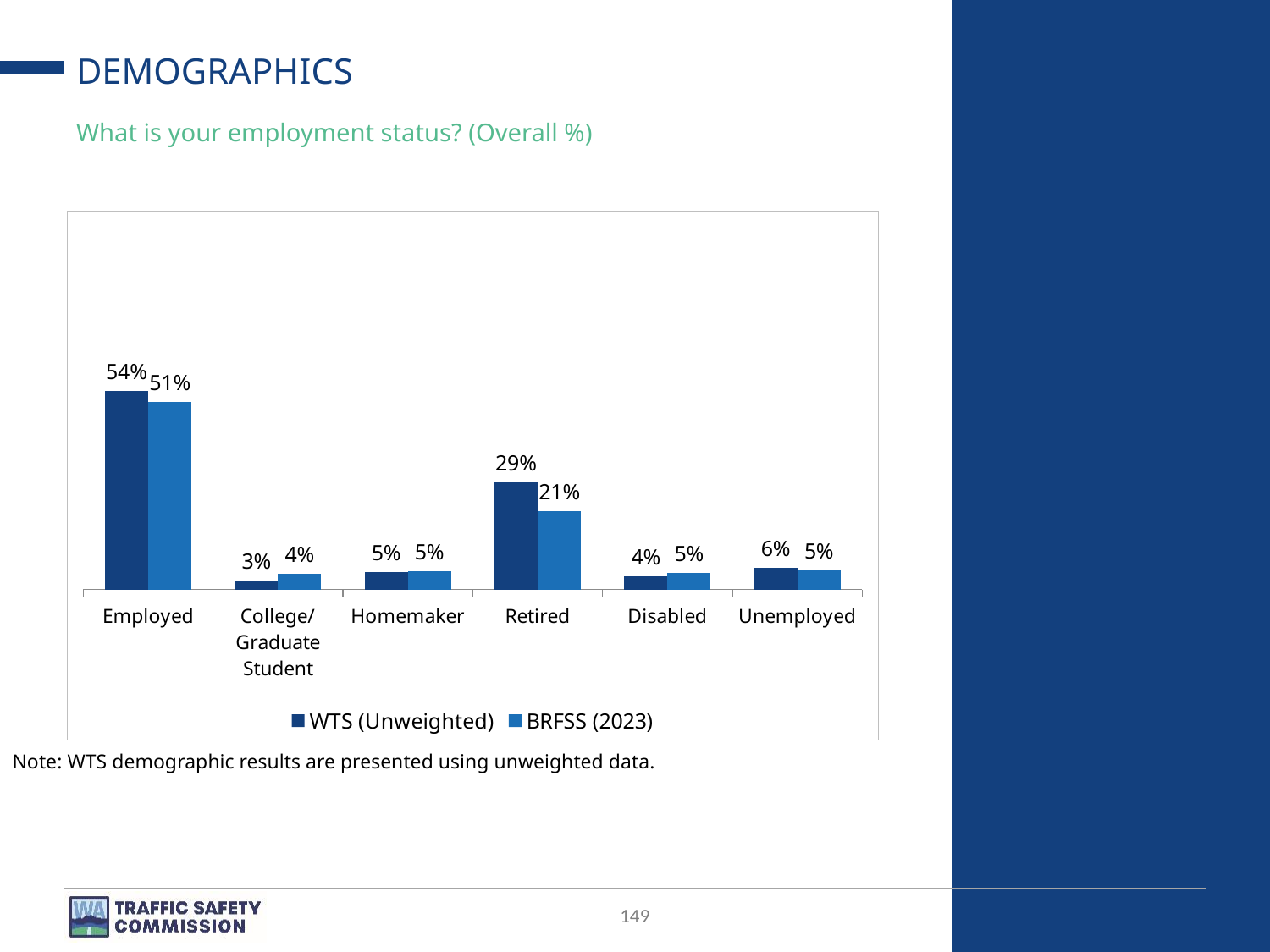
How many employment status categories are shown on the chart? 6 What is the difference between the WTS (Unweighted) and BRFSS (2023) values for Retired? 8% What are the two series named in the chart legend? WTS (Unweighted) and BRFSS (2023) Which employment status category has the lowest WTS (Unweighted) value? College/Graduate Student How many series does the legend list? 2 What kind of chart is shown on the slide? Bar chart Which employment status category has the highest WTS (Unweighted) value? Employed What is the WTS (Unweighted) value for Employed? 54% What is the BRFSS (2023) value for Retired? 21% What is the WTS (Unweighted) value for College/Graduate Student? 3% What is the difference between the WTS (Unweighted) and BRFSS (2023) values for Employed? 3% Which is larger for Disabled: the WTS (Unweighted) value or the BRFSS (2023) value? BRFSS (2023)